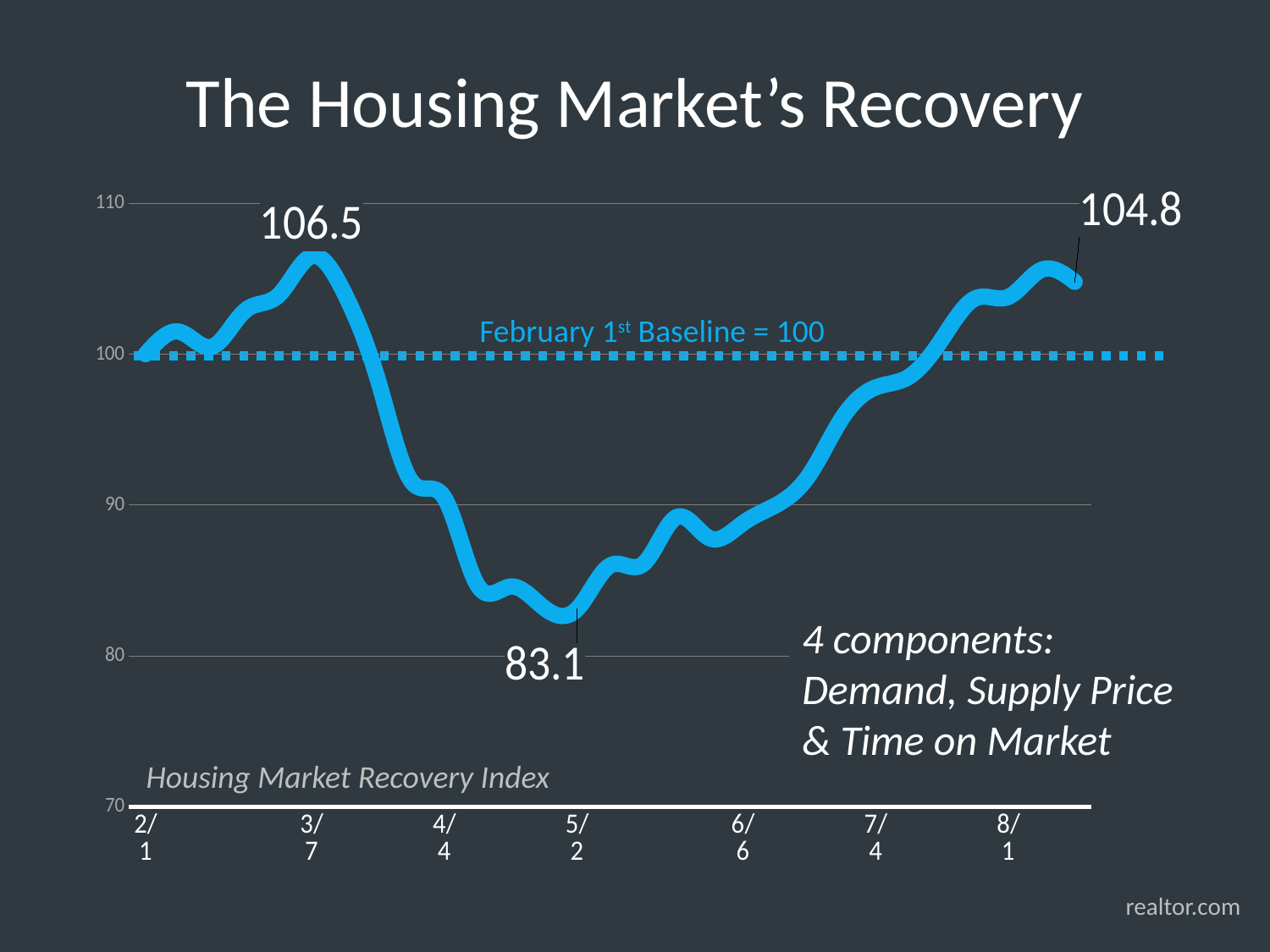
Is the index value at 5/2 greater or less than 90? less What value does the dashed horizontal baseline represent, according to its label? February 1st Baseline = 100 How many date labels are shown on the x axis? 7 How much higher is the peak of 106.5 than the final labelled value of 104.8? 1.7 Which is larger, the labelled value near 3/7 or the labelled value at the end of the line? The value near 3/7 (106.5) Does the index rise or fall between 3/7 and 5/2? Fall What is the difference between the peak value of 106.5 and the low of 83.1? 23.4 Is the index value at 7/4 greater or less than 100? less What is the lowest value labelled on the Housing Market Recovery Index line? 83.1 What is the last labelled value at the right end of the line, after 8/1? 104.8 What kind of chart is shown on the slide? Line chart What is the highest value labelled on the Housing Market Recovery Index line? 106.5